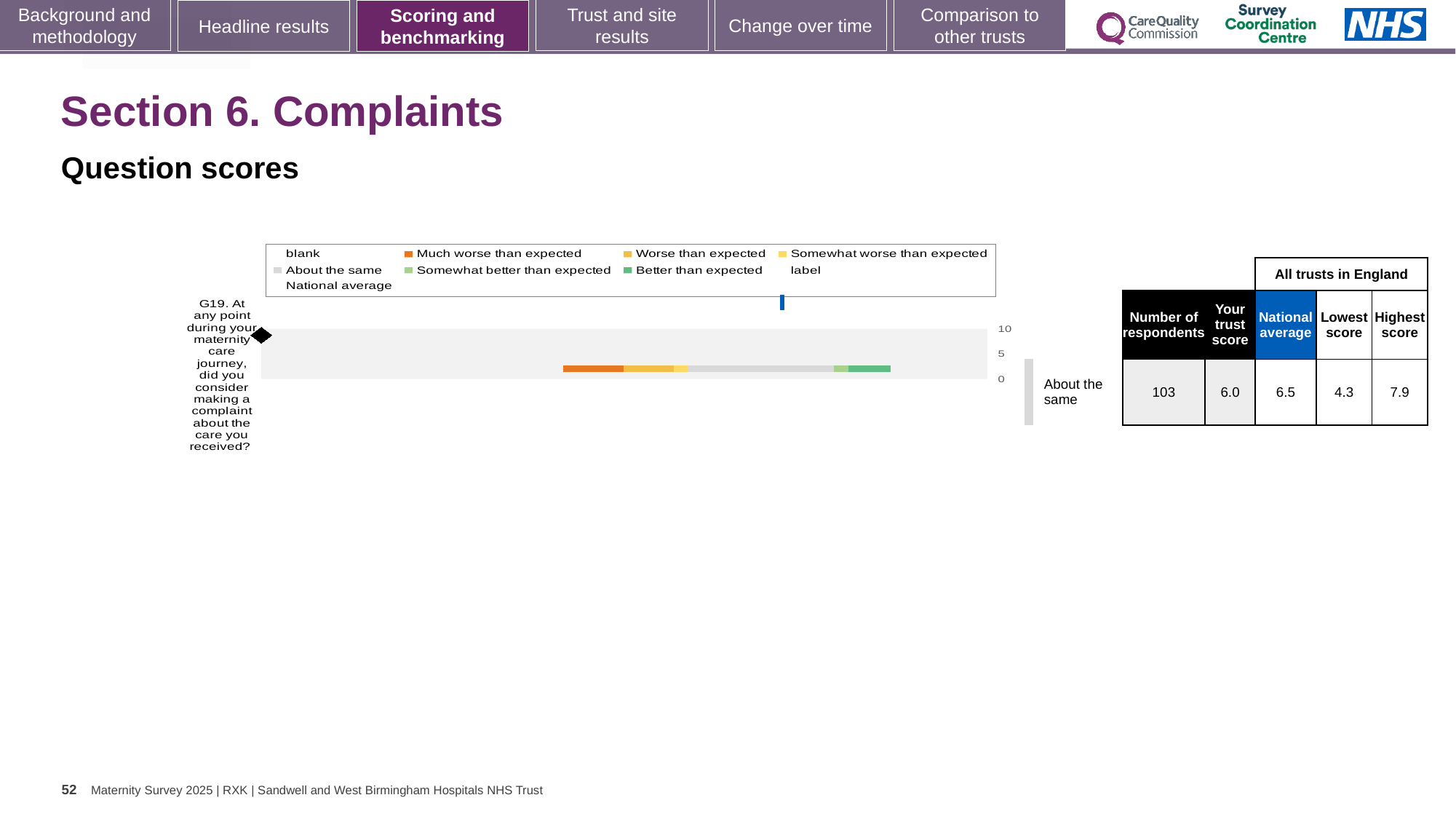
How many survey questions are plotted on the chart? 1 What is the highest score among all trusts in England for question G19? 7.9 What kind of chart is shown on the slide for question G19? bar chart What is the difference between the national average and the trust score for question G19? 0.5 Which is larger for question G19, the trust score or the national average? national average What is the trust's score for question G19 shown alongside the chart? 6.0 What is the lowest score among all trusts in England for question G19? 4.3 Which question is plotted on the chart? G19. At any point during your maternity care journey, did you consider making a complaint about the care you received? Which benchmark category does the trust's score for question G19 fall into? About the same How many respondents answered question G19? 103 What is the national average for question G19 shown alongside the chart? 6.5 What is the difference between the highest and lowest scores among all trusts in England for question G19? 3.6